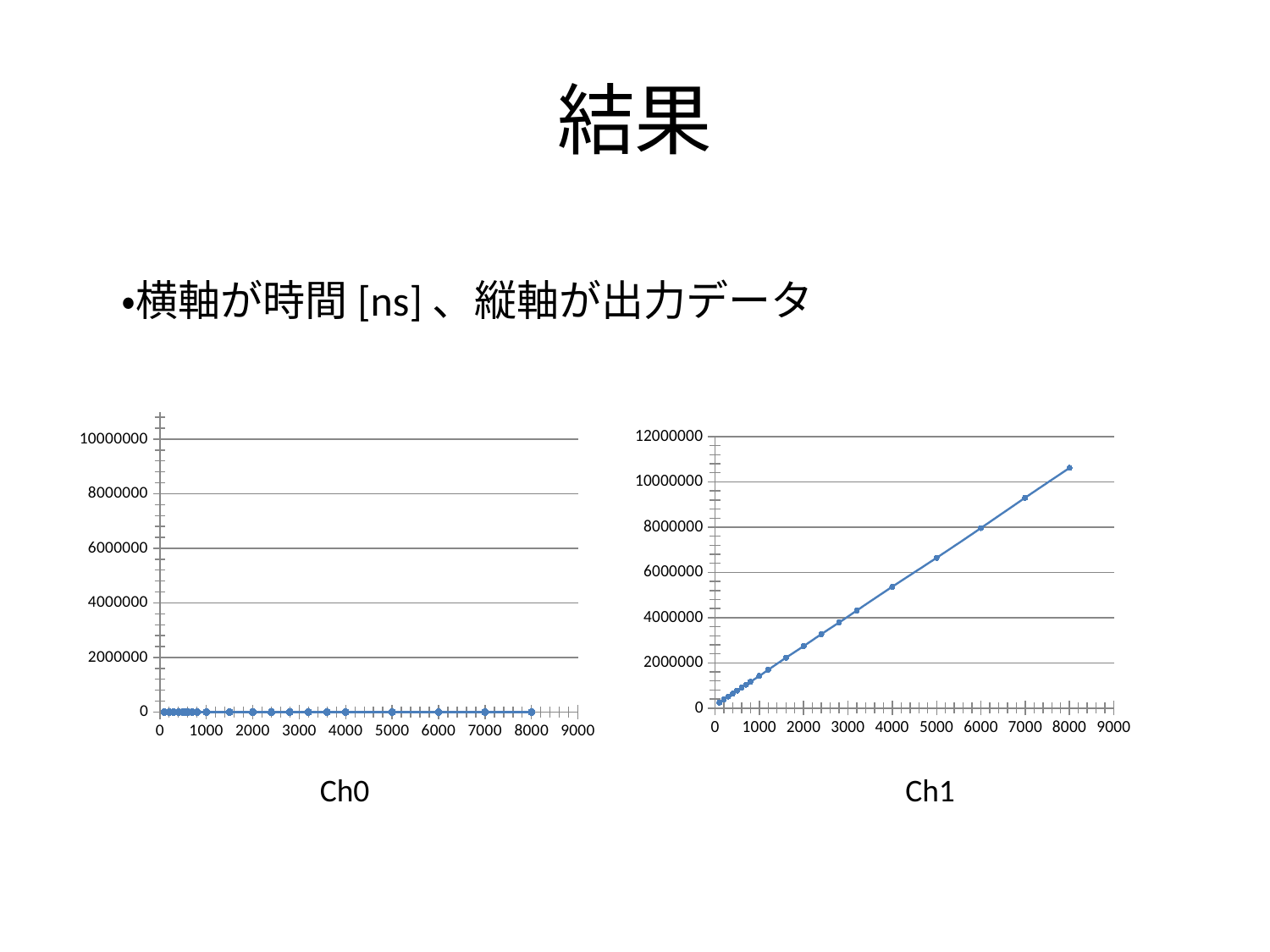
In the Ch1 chart, which has the larger value: x = 1000 or x = 8000? x = 8000 What is the highest tick label on the y axis of the Ch0 chart? 10000000 In the Ch0 chart, do the values rise, fall, or stay flat as the x axis increases? stay flat In the Ch1 chart, is the value at x = 8000 greater or less than 10000000? greater In the Ch0 chart, is the value at x = 8000 greater or less than 2000000? less What kind of chart is the Ch1 chart on the right? line chart What is the highest tick label on the y axis of the Ch1 chart? 12000000 In the Ch1 chart, do the values rise or fall as the x axis increases? rise What kind of chart is the Ch0 chart on the left? line chart In the Ch1 chart, is the value at x = 4000 greater or less than 4000000? greater